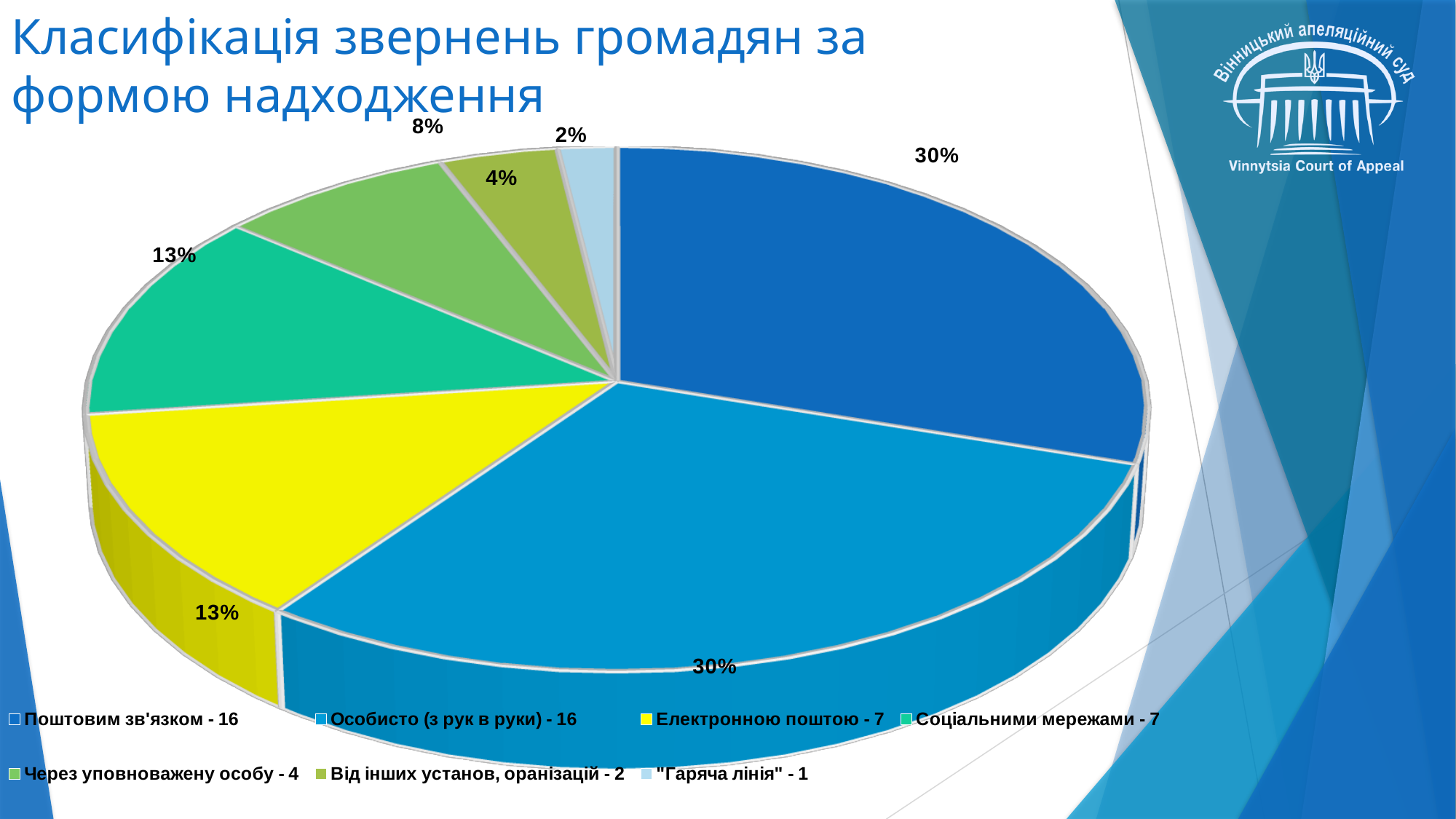
What number is shown in the legend for "Соціальними мережами"? 7 What is the difference in percentage points between the share for "Поштовим зв'язком" and the share for "Соціальними мережами"? 17 What share of the pie does "Електронною поштою" represent? 13% Which category has the smallest slice of the pie? "Гаряча лінія" Which is larger, the share for "Через уповноважену особу" or the share for "Від інших установ, оранізацій"? Через уповноважену особу What share of the pie does "Через уповноважену особу" represent? 8% What kind of chart is shown on the slide? Pie chart What number is shown in the legend for "Від інших установ, оранізацій"? 2 How many slices does the pie chart have? 7 What share of the pie does "Гаряча лінія" represent? 2% What is the title of the slide containing the chart? Класифікація звернень громадян за формою надходження